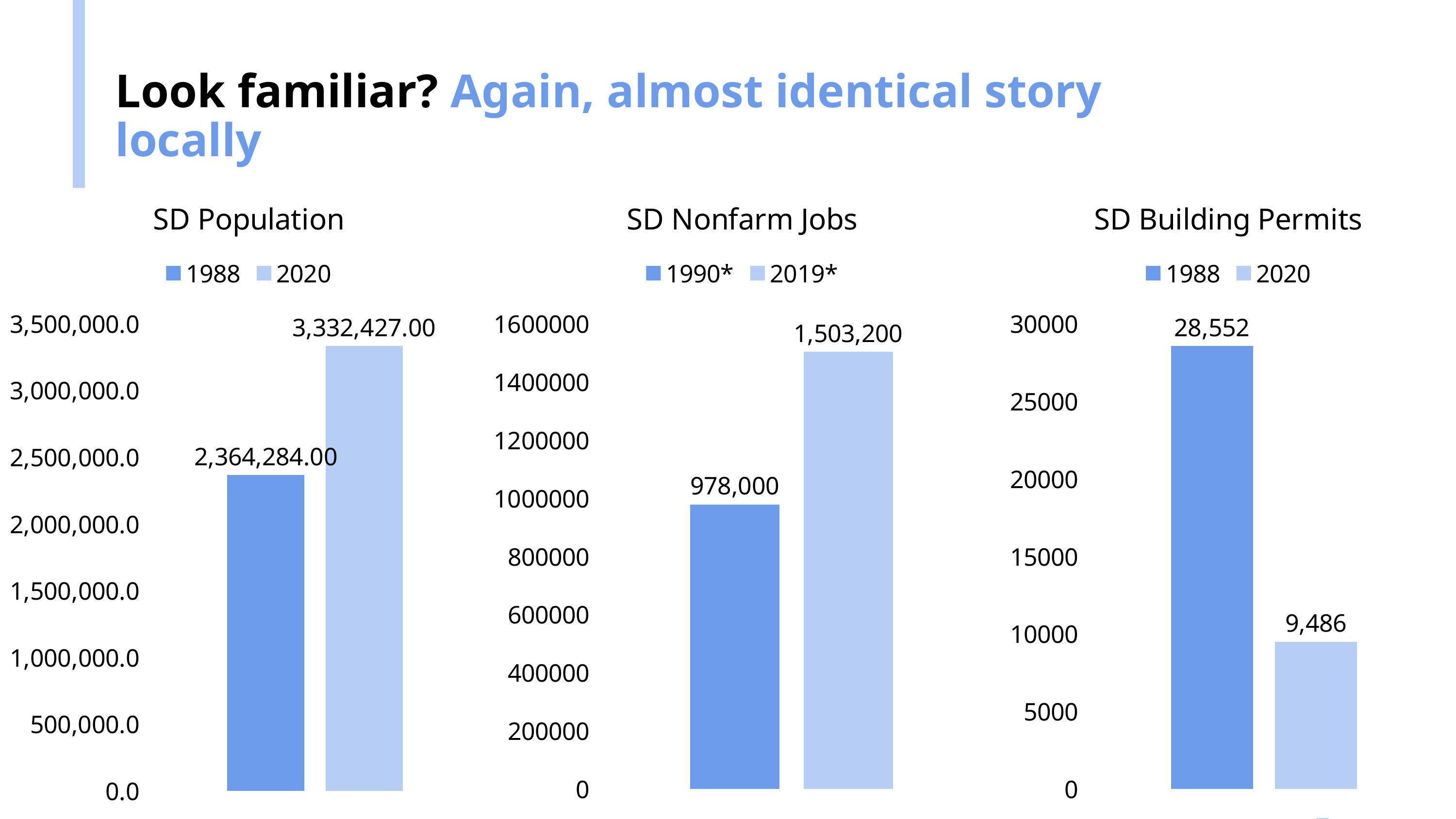
What kind of chart is the SD Nonfarm Jobs chart? bar chart In the SD Nonfarm Jobs chart, what is the value for 1990*? 978,000 In the SD Building Permits chart, what is the value for 1988? 28,552 In the SD Nonfarm Jobs chart, what is the value for 2019*? 1,503,200 In the SD Nonfarm Jobs chart, what is the difference between the 2019* and 1990* values? 525,200 In the SD Population chart, what is the value for 2020? 3,332,427.00 In the SD Nonfarm Jobs chart, which year has the lower value? 1990* In the SD Building Permits chart, which year has the higher value? 1988 In the SD Building Permits chart, what is the value for 2020? 9,486 In the SD Building Permits chart, what is the difference between the 1988 and 2020 values? 19,066 In the SD Population chart, what is the value for 1988? 2,364,284.00 In the SD Population chart, is the value for 2020 larger or smaller than the value for 1988? larger